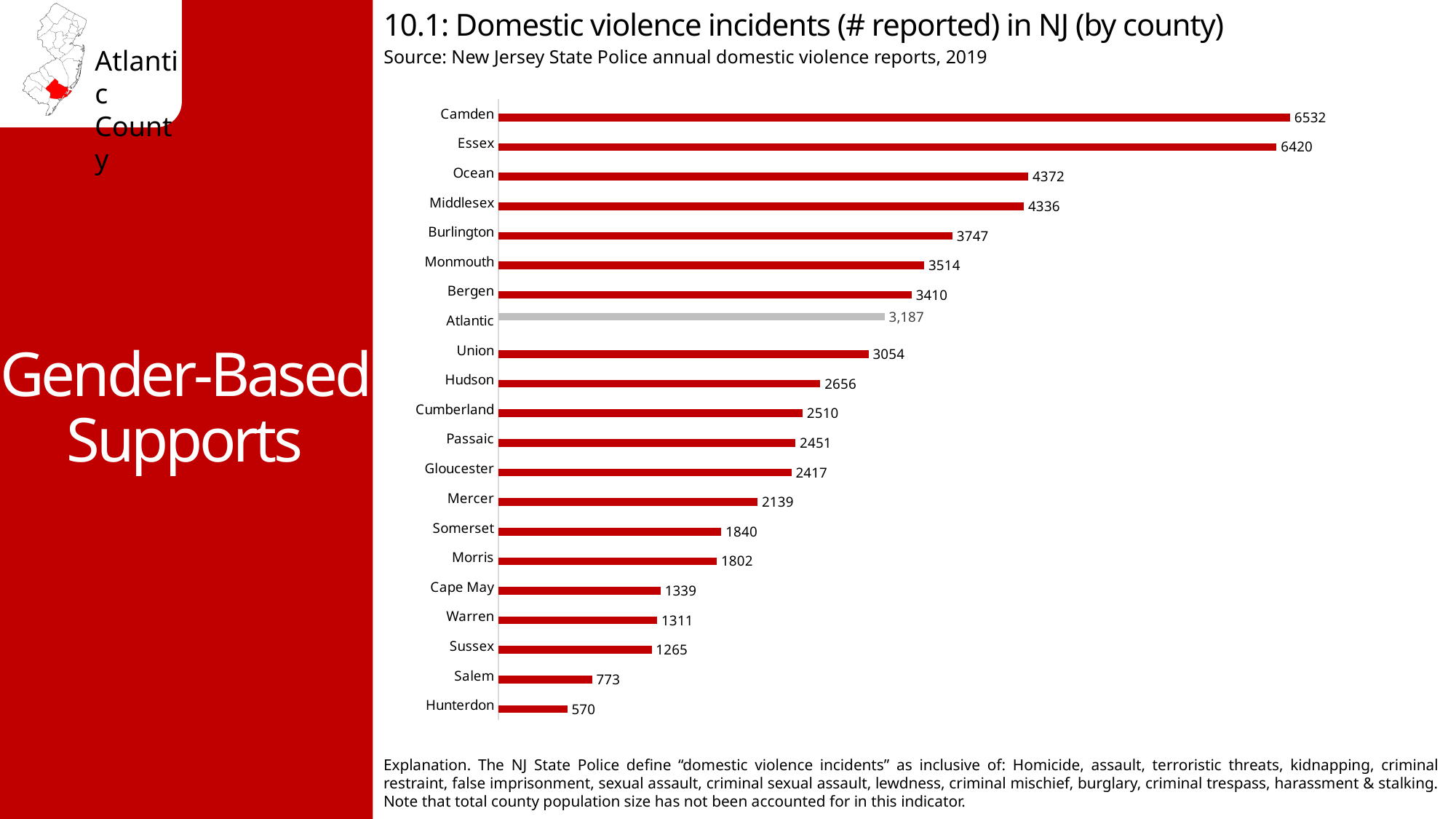
Which county has more reported incidents, Bergen or Union? Bergen What is the difference in reported incidents between Ocean and Middlesex? 36 What kind of chart is used to show domestic violence incidents by county? Bar chart What is the number of reported domestic violence incidents for Camden? 6532 Which county's bar is shown in grey rather than red? Atlantic What is the difference in reported incidents between Camden and Essex? 112 Which county has the highest number of reported domestic violence incidents? Camden Which county has the lowest number of reported domestic violence incidents? Hunterdon Which county has more reported incidents, Salem or Sussex? Sussex What is the number of reported domestic violence incidents for Atlantic County? 3,187 How many counties are shown in the chart? 21 What is the number of reported domestic violence incidents for Hunterdon? 570